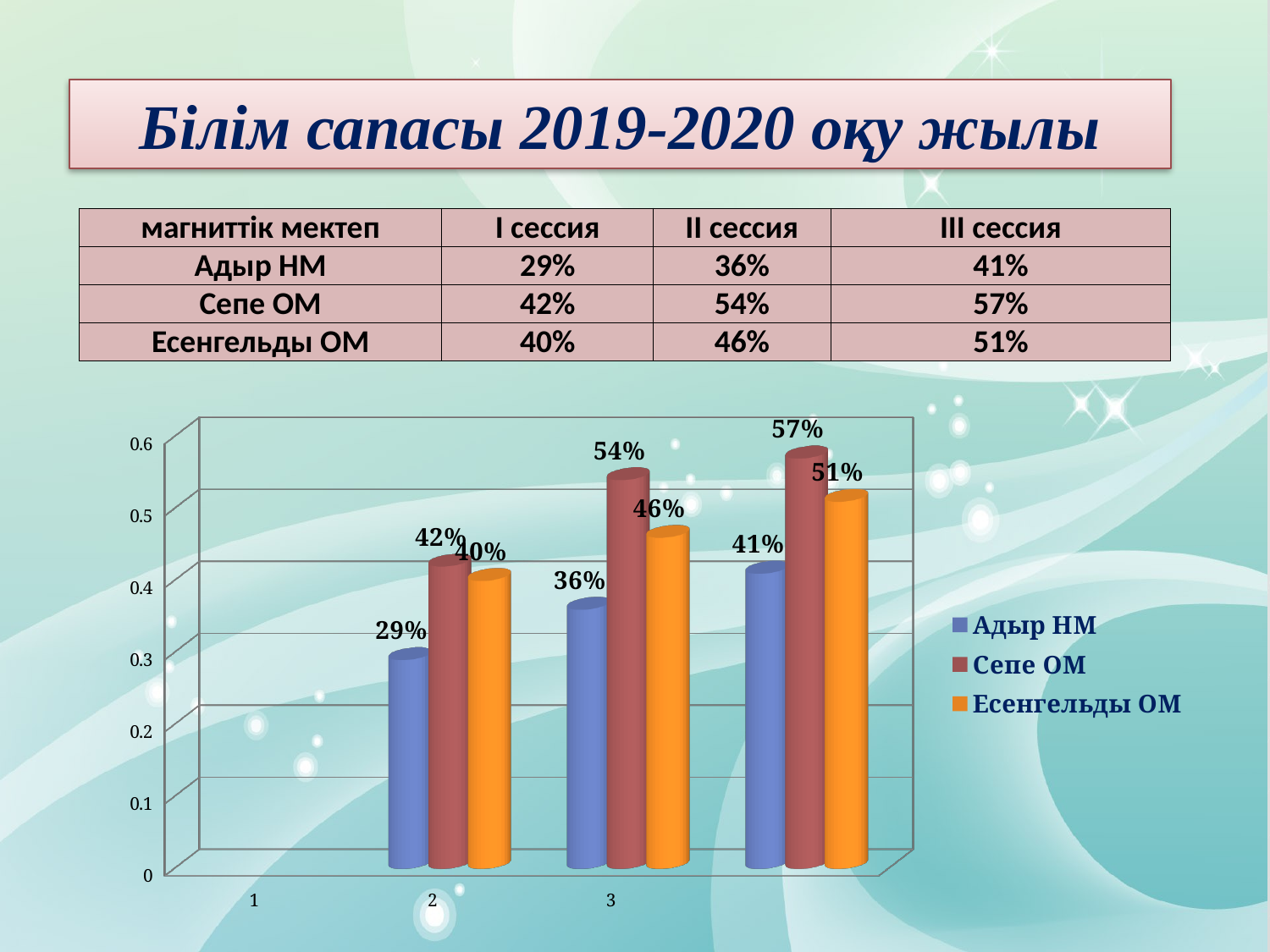
What type of chart is shown on the slide? bar chart Do the Адыр НМ values rise or fall from category 1 to category 3 in the chart? rise What is the value of the Есенгельды ОМ bar in category 3 of the chart? 46% What colour are the Есенгельды ОМ bars in the chart? orange What is the difference between the Сепе ОМ and Адыр НМ values in category 3 of the chart? 18% How many series does the chart legend list? 3 In category 2 of the chart, which is larger: the Есенгельды ОМ value or the Адыр НМ value? Есенгельды ОМ Which series has the highest bar in category 3 of the chart? Сепе ОМ How many category groups are plotted along the x axis of the chart? 3 What is the value of the Сепе ОМ bar in category 2 of the chart? 42%